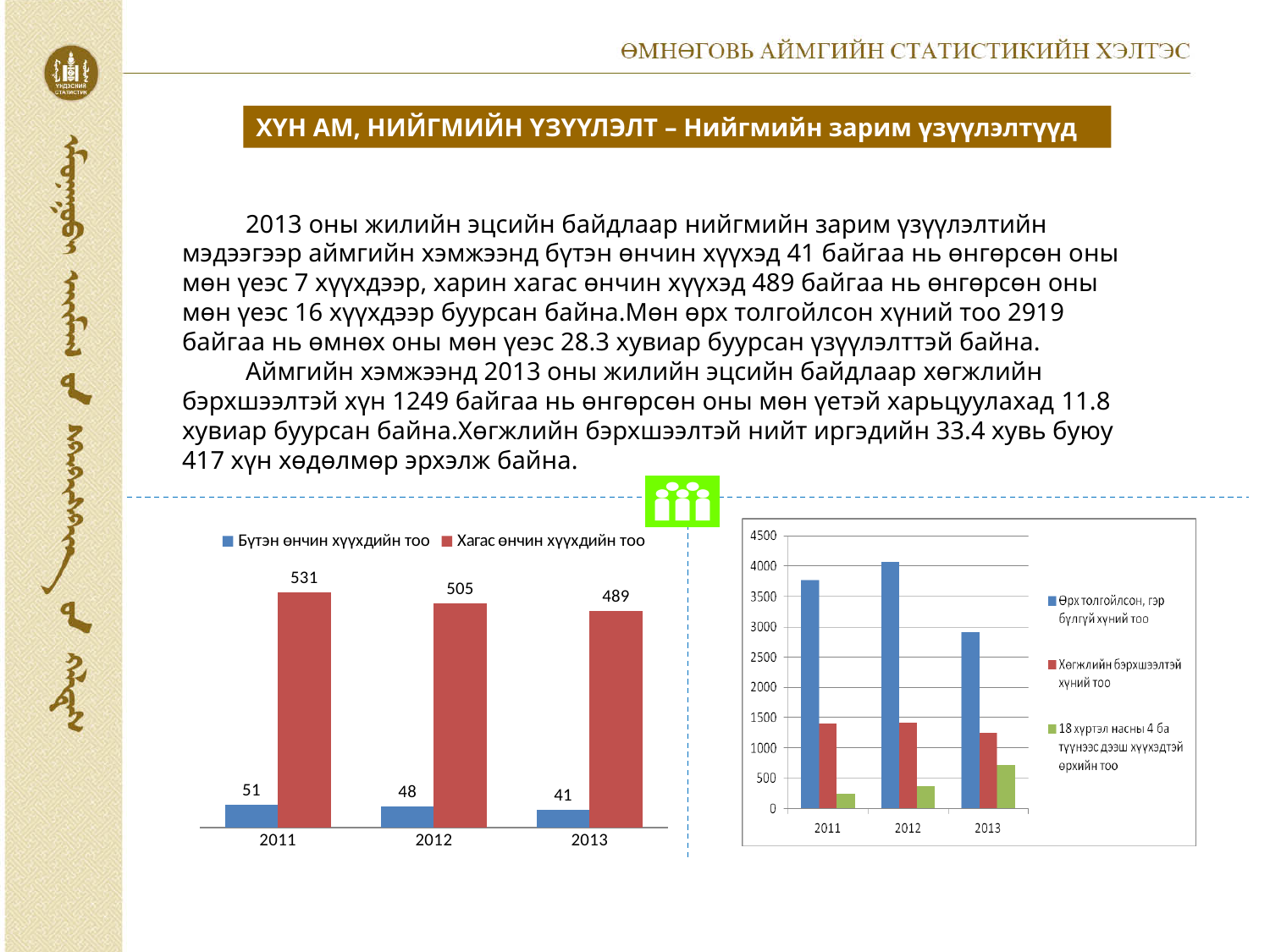
In the left chart, which year has the lowest value for Бүтэн өнчин хүүхдийн тоо? 2013 In the right chart, which year has the highest value for Өрх толгойлсон, гэр бүлгүй хүний тоо? 2012 In the left chart, what is the value for Бүтэн өнчин хүүхдийн тоо in 2013? 41 In the right chart, how many series does the legend list? 3 In the right chart, is the value for Өрх толгойлсон, гэр бүлгүй хүний тоо in 2012 greater or less than 4000? greater In the left chart, how many series does the legend list? 2 In the left chart, do the values for Хагас өнчин хүүхдийн тоо rise or fall from 2011 to 2013? fall What kind of chart is the right chart? bar chart In the left chart, what is the value for Хагас өнчин хүүхдийн тоо in 2011? 531 In the left chart, what is the difference between the Хагас өнчин хүүхдийн тоо values for 2012 and 2013? 16 In the right chart, is the value for 18 хүртэл насны 4 ба түүнээс дээш хүүхэдтэй өрхийн тоо in 2013 greater or less than 500? greater In the left chart, which year has the highest value for Хагас өнчин хүүхдийн тоо? 2011